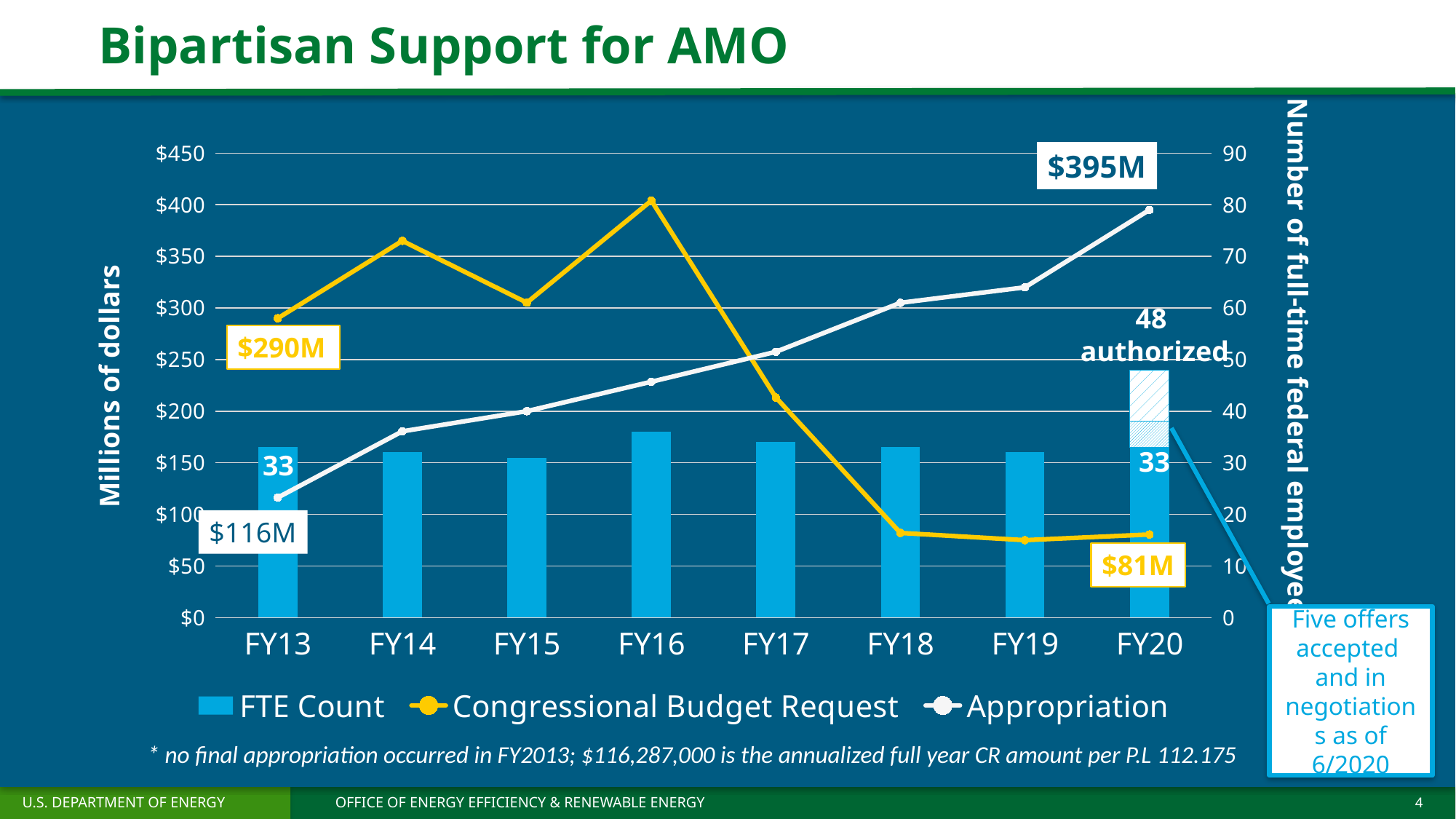
What is the FTE Count labeled for FY13? 33 Which is larger for FY20: the Appropriation or the Congressional Budget Request? Appropriation In which fiscal year is the Congressional Budget Request highest? FY16 In which fiscal year is the Appropriation lowest? FY13 In which fiscal year is the Appropriation highest? FY20 What is the Congressional Budget Request value labeled for FY20? $81M How many fiscal years are shown on the x axis? 8 How many series does the legend list? 3 What is the Congressional Budget Request value labeled for FY13? $290M What is the Appropriation value labeled for FY20? $395M What is the difference between the FY20 Appropriation ($395M) and the FY13 Appropriation ($116M)? $279M Is the Appropriation for FY14 greater or less than $200? less